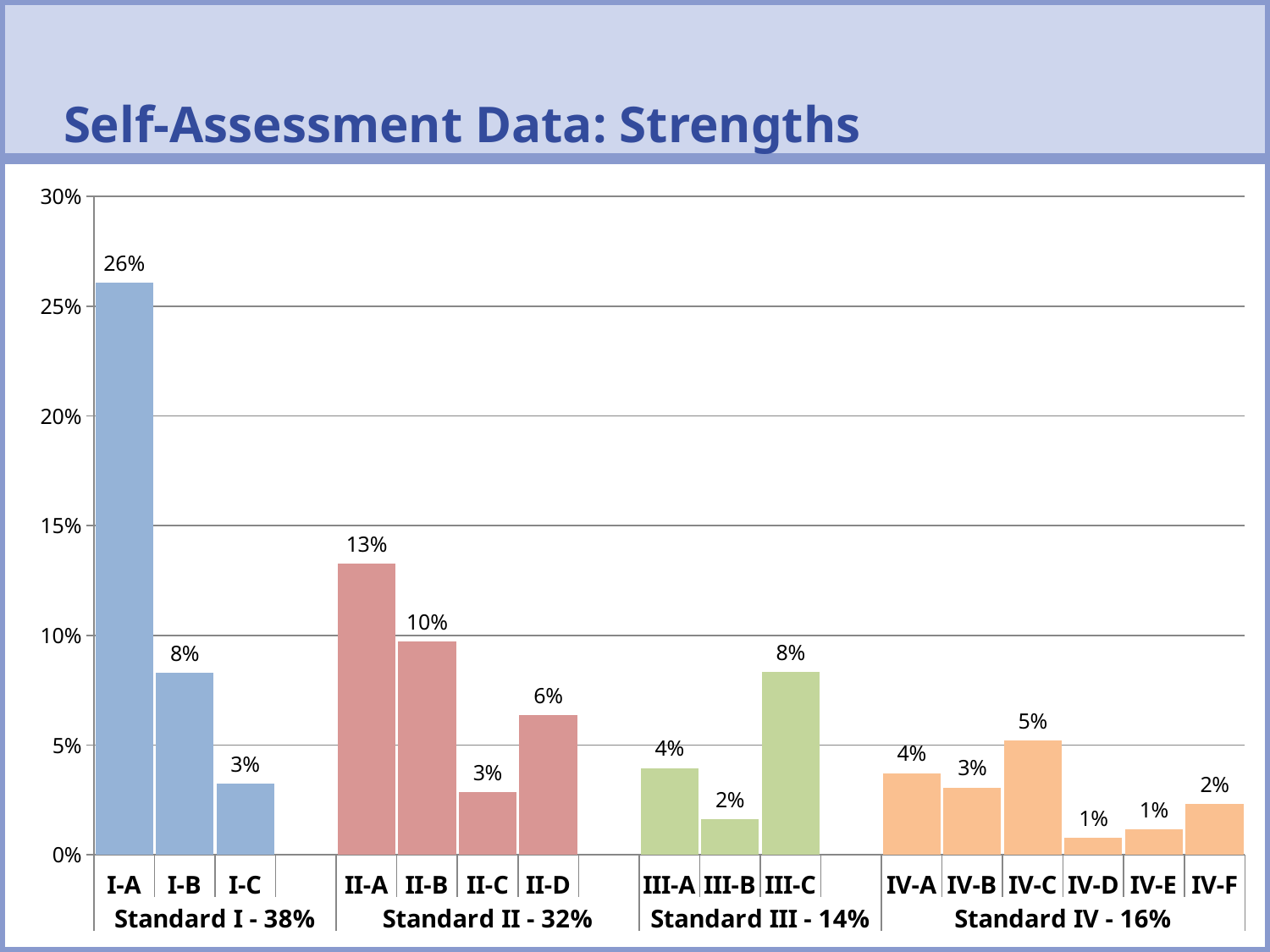
What is the value for I-A? 26% Is the value for I-A greater or less than 25%? greater What is the value for II-D? 6% Which category has the highest value? I-A Within Standard III, which category has the lowest value? III-B What is the title of the slide? Self-Assessment Data: Strengths What is the value for III-C? 8% How many bars are plotted in the chart? 16 What is the value for IV-C? 5% What is the difference between the values for I-A and II-A? 13% Which is larger, the value for II-B or the value for III-C? II-B What kind of chart is shown on the slide? Bar chart